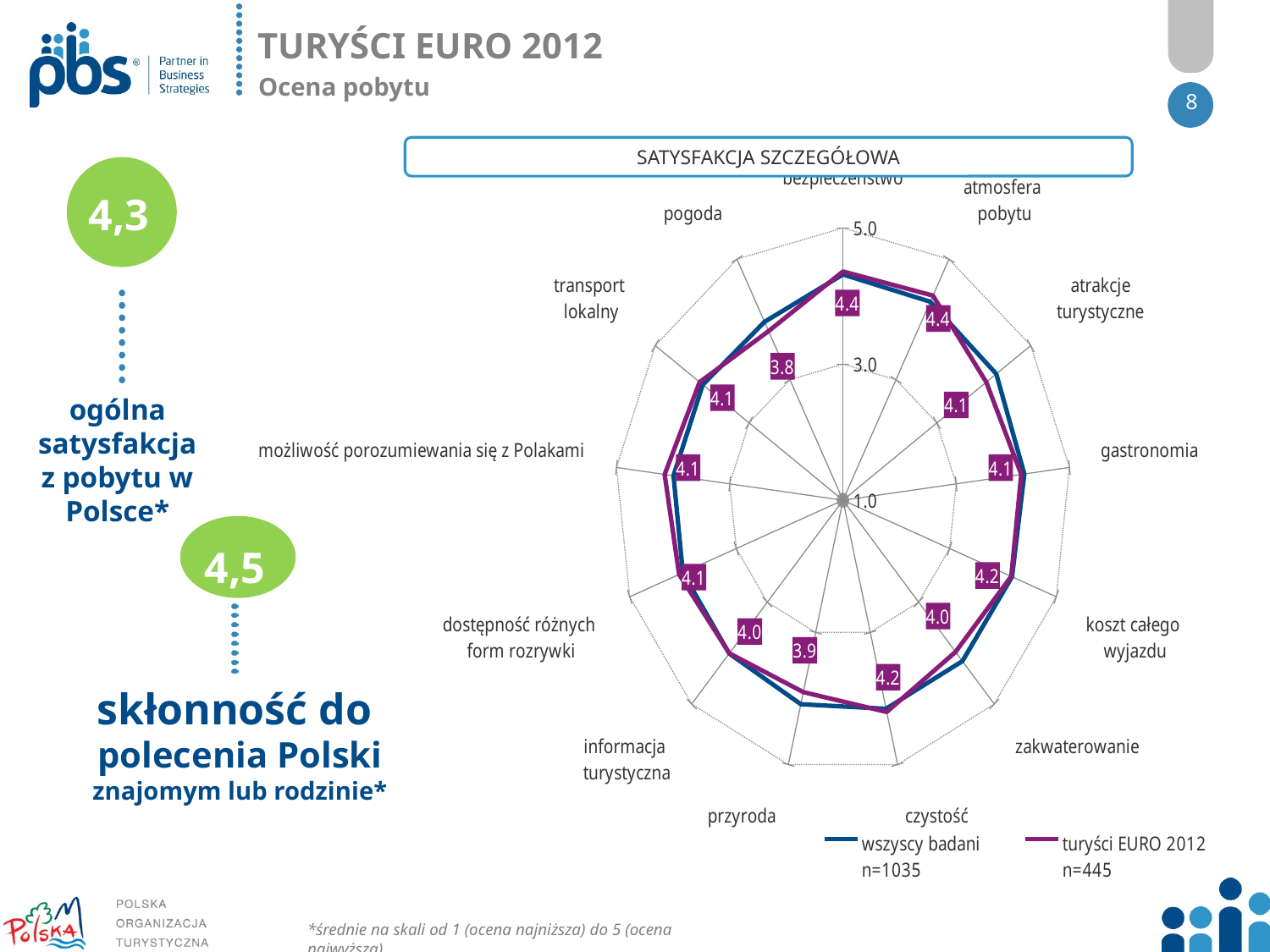
On the radar chart, is the value for pogoda greater or less than 3.0? greater What sample size (n) does the legend give for the series 'turyści EURO 2012'? n=445 How many categories (axes) does the radar chart have? 13 How many series does the legend of the radar chart list? 2 According to the data labels on the radar chart, what is the value for bezpieczeństwo? 4.4 According to the data labels on the radar chart, what is the value for przyroda? 3.9 Which category has the lowest labelled value on the radar chart? pogoda What is the difference between the labelled values for bezpieczeństwo and pogoda on the radar chart? 0.6 What kind of chart is shown under the title SATYSFAKCJA SZCZEGÓŁOWA? radar chart On the radar chart, which has the larger labelled value: koszt całego wyjazdu or przyroda? koszt całego wyjazdu According to the data labels on the radar chart, what is the value for koszt całego wyjazdu? 4.2 According to the data labels on the radar chart, what is the value for pogoda? 3.8